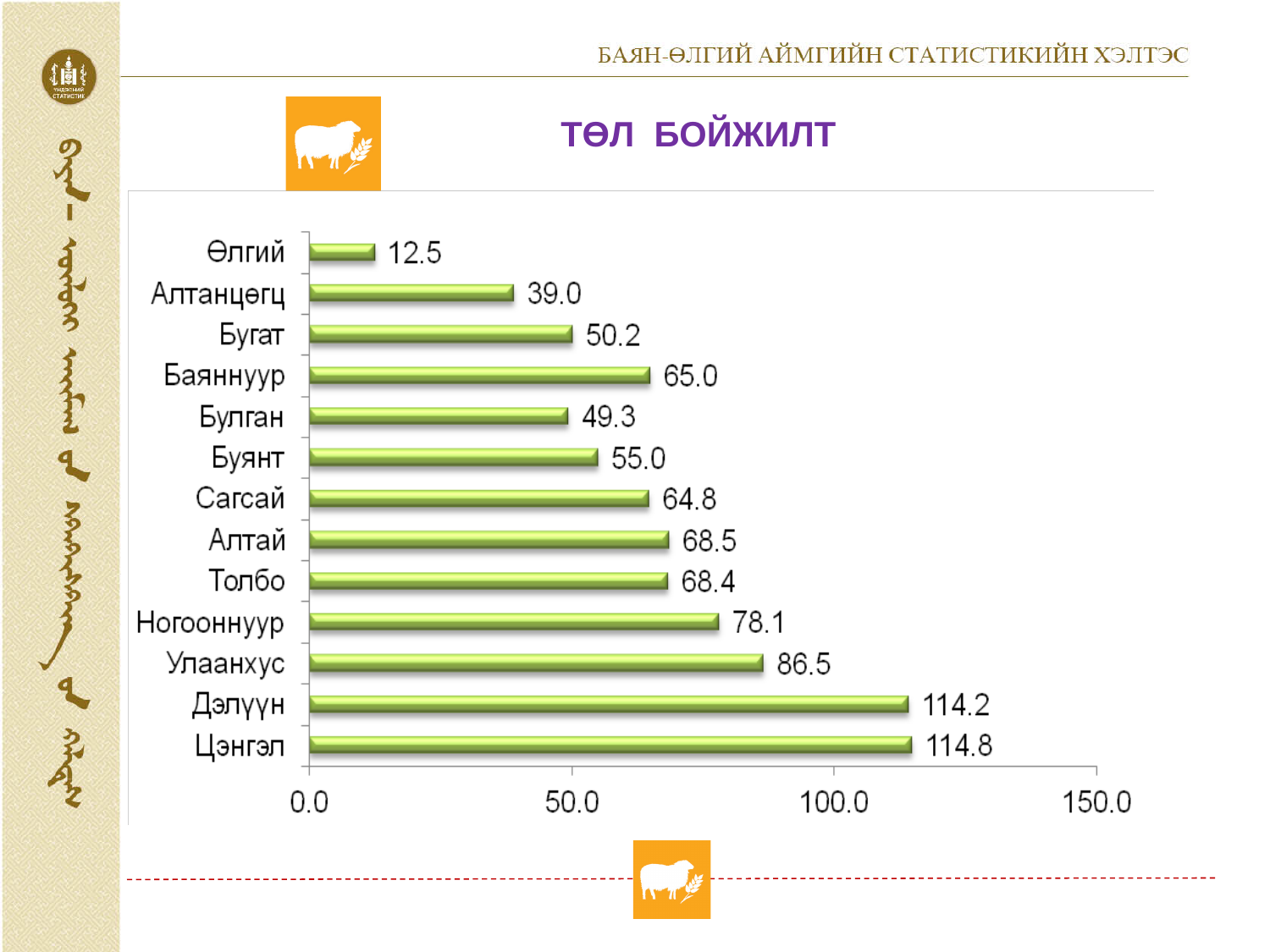
What is the difference between the values for Улаанхус and Ногооннуур? 8.4 Which category has the highest value? Цэнгэл What is the difference between the values for Баяннуур and Бугат? 14.8 Which category has the lowest value? Өлгий Is the value for Алтанцөгц greater or less than 50.0? less What kind of chart is shown on the slide? Bar chart What is the value for Дэлүүн? 114.2 What is the value for Улаанхус? 86.5 Which is larger, the value for Буянт or the value for Булган? Буянт How many categories are shown in the chart? 13 What is the value for Сагсай? 64.8 What is the value for Өлгий? 12.5